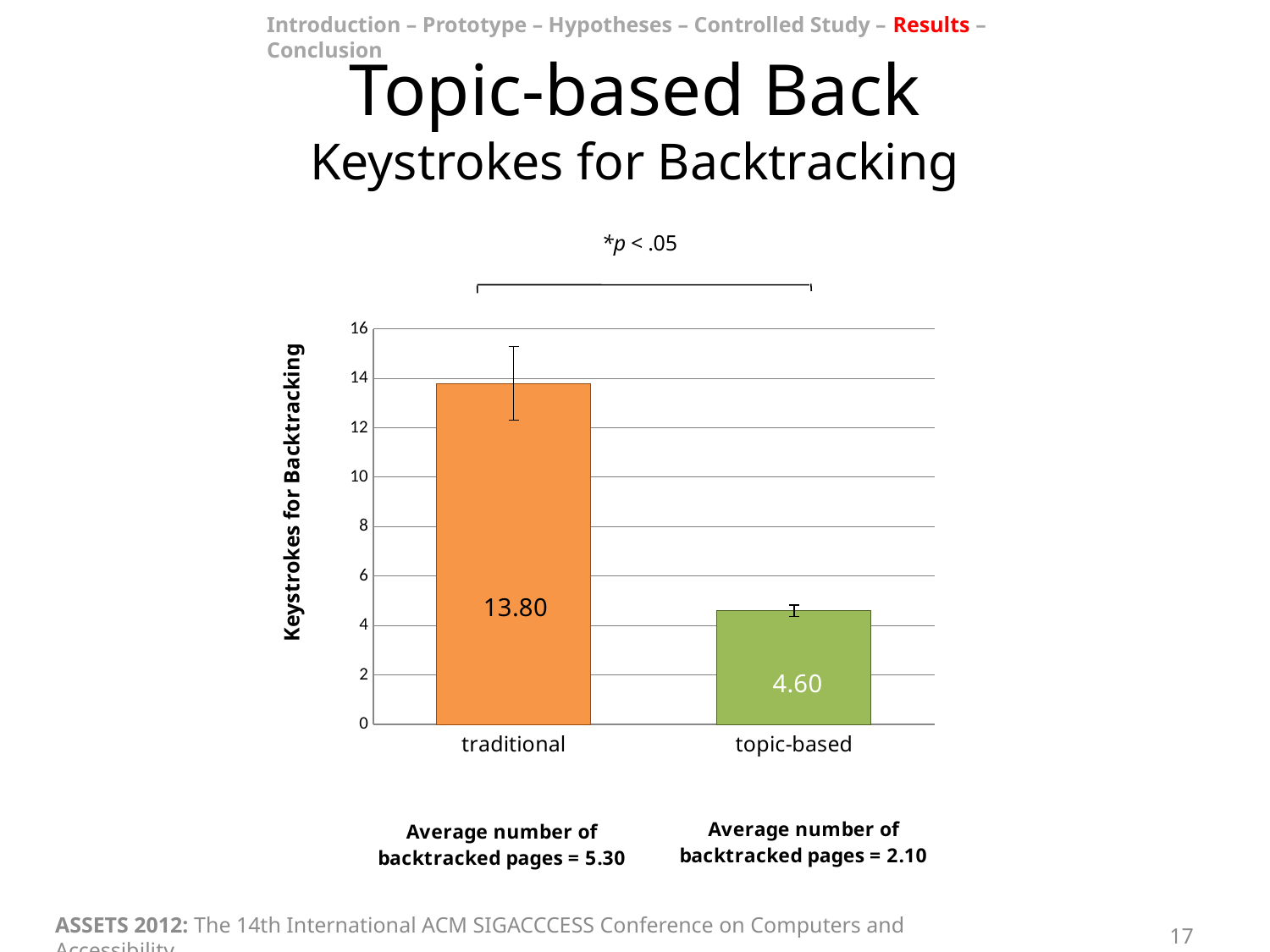
Which is larger, the value for traditional or the value for topic-based? traditional What colour is the bar for topic-based? green Which category has the highest keystrokes for backtracking? traditional What is the value for topic-based? 4.60 What is the value for traditional? 13.80 What is the label of the y axis? Keystrokes for Backtracking Which category has the lowest keystrokes for backtracking? topic-based What is the difference between the traditional and topic-based values? 9.20 How many categories are shown on the x axis? 2 What kind of chart is shown? bar chart Is the value for traditional greater or less than 12? greater Is the value for topic-based greater or less than 6? less